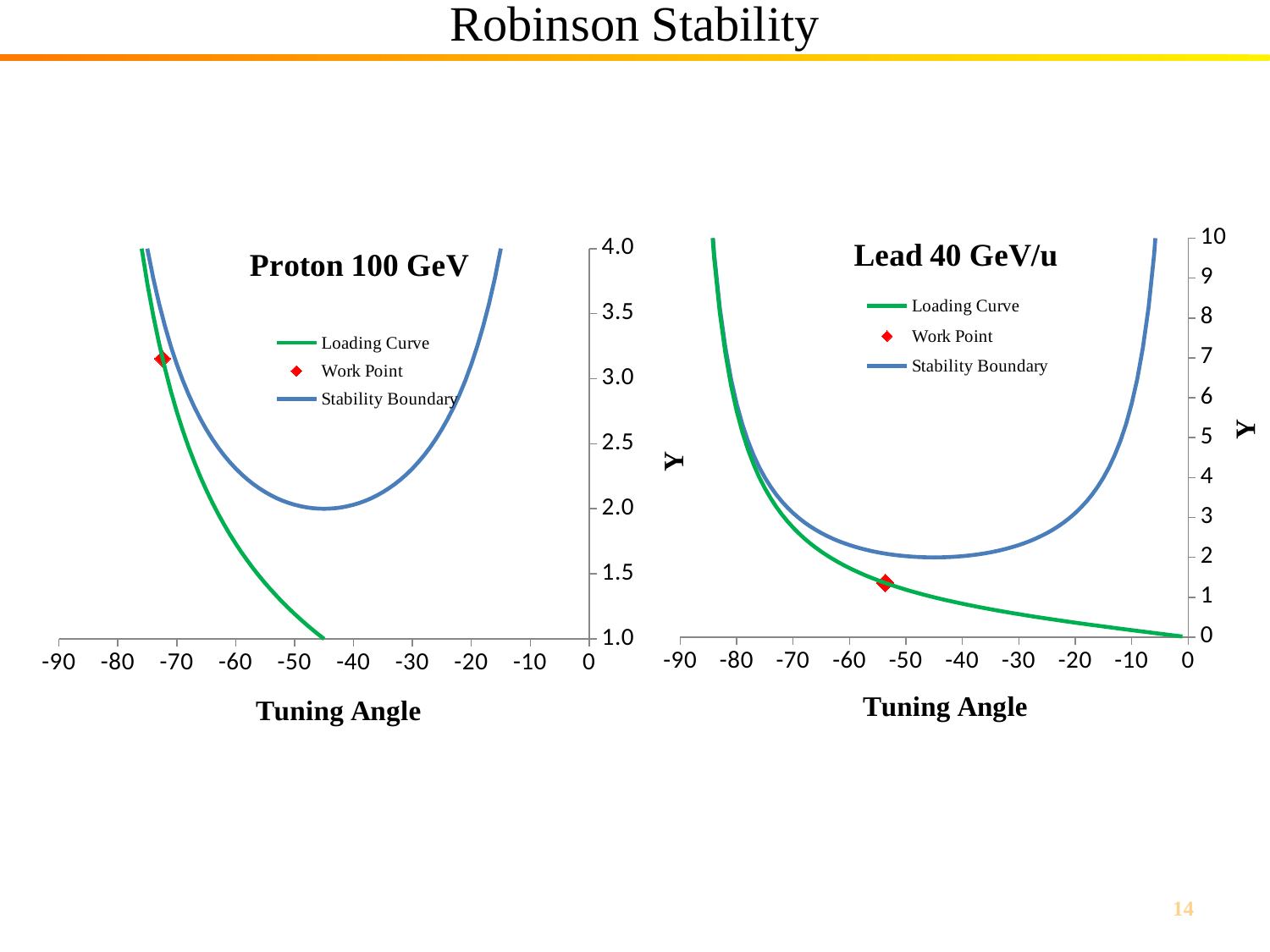
In the Proton 100 GeV chart, is the Y value of the Work Point greater or less than 2.5? greater In the Proton 100 GeV chart, which series is drawn in green? Loading Curve In the Proton 100 GeV chart, is the Work Point's Tuning Angle greater or less than -60? less What kind of chart is the Proton 100 GeV chart? Line chart In the Lead 40 GeV/u chart, is the Y value of the Work Point greater or less than 5? less In the Proton 100 GeV chart, does the Loading Curve rise or fall as the Tuning Angle increases from -90 toward 0? fall What is the x-axis label of the Lead 40 GeV/u chart? Tuning Angle In the Proton 100 GeV chart, how many series does the legend list? 3 In the Lead 40 GeV/u chart, does the Loading Curve rise or fall as the Tuning Angle increases from -90 toward 0? fall In the Lead 40 GeV/u chart, how many series does the legend list? 3